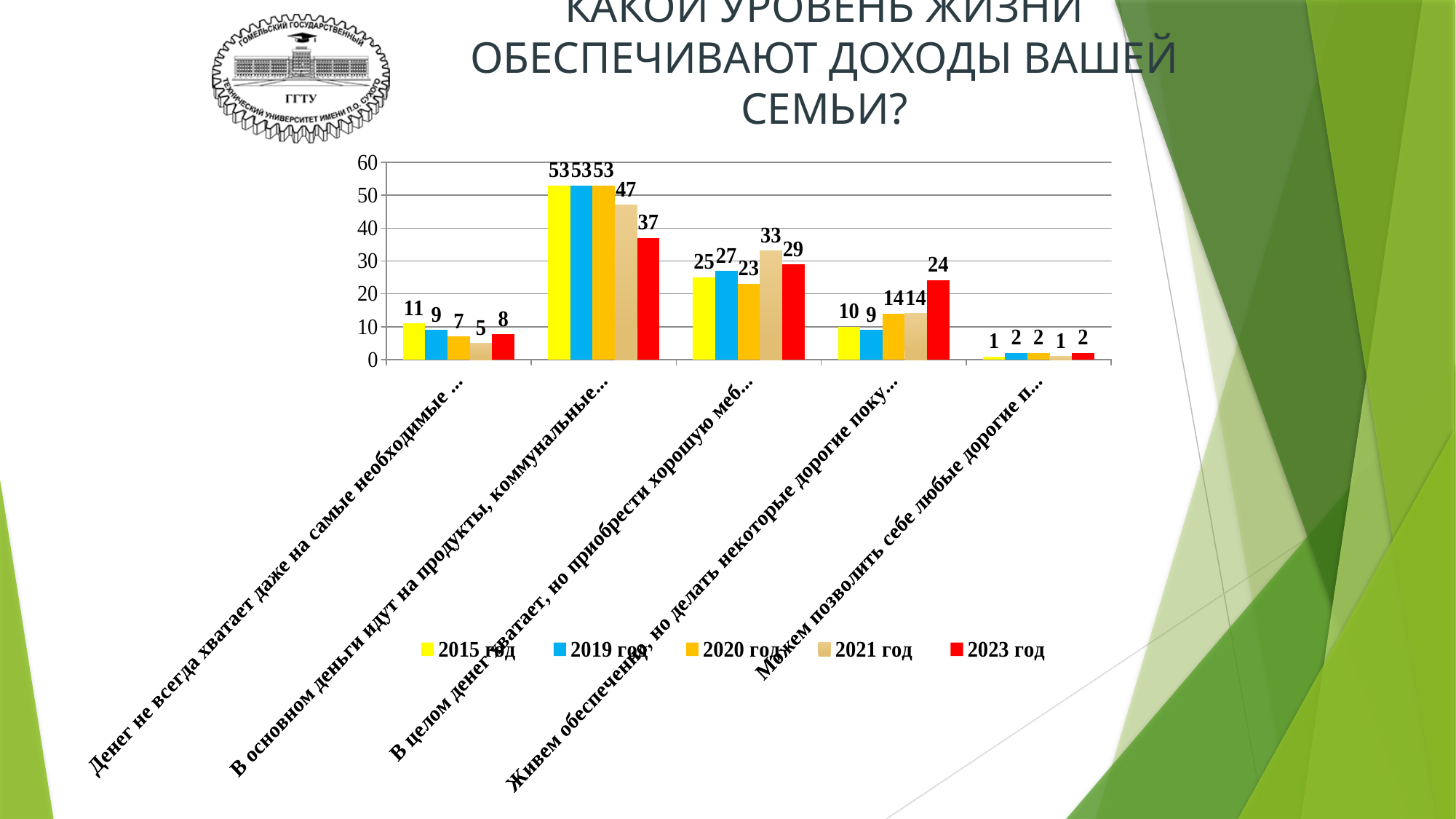
Which year has the lowest value in the category "Денег не всегда хватает даже на самые необходимые..."? 2021 год Which colour represents 2023 год in the legend? red What is the difference between the 2015 год and 2023 год values in the category "В основном деньги идут на продукты, коммунальные..."? 16 How many series does the legend list? 5 What is the value for 2023 год in the category "В основном деньги идут на продукты, коммунальные..."? 37 What kind of chart is shown on the slide? bar chart Which year has the highest value in the category "Живем обеспеченно, но делать некоторые дорогие поку..."? 2023 год What is the value for 2015 год in the category "Денег не всегда хватает даже на самые необходимые..."? 11 What is the value for 2021 год in the category "В целом денег хватает, но приобрести хорошую меб..."? 33 How do the values for 2023 год change across the first two categories, from "Денег не всегда хватает..." to "В основном деньги идут на продукты..."? rise How many categories are shown on the x axis? 5 In the category "В целом денег хватает, но приобрести хорошую меб...", which is larger: the value for 2019 год or for 2020 год? 2019 год